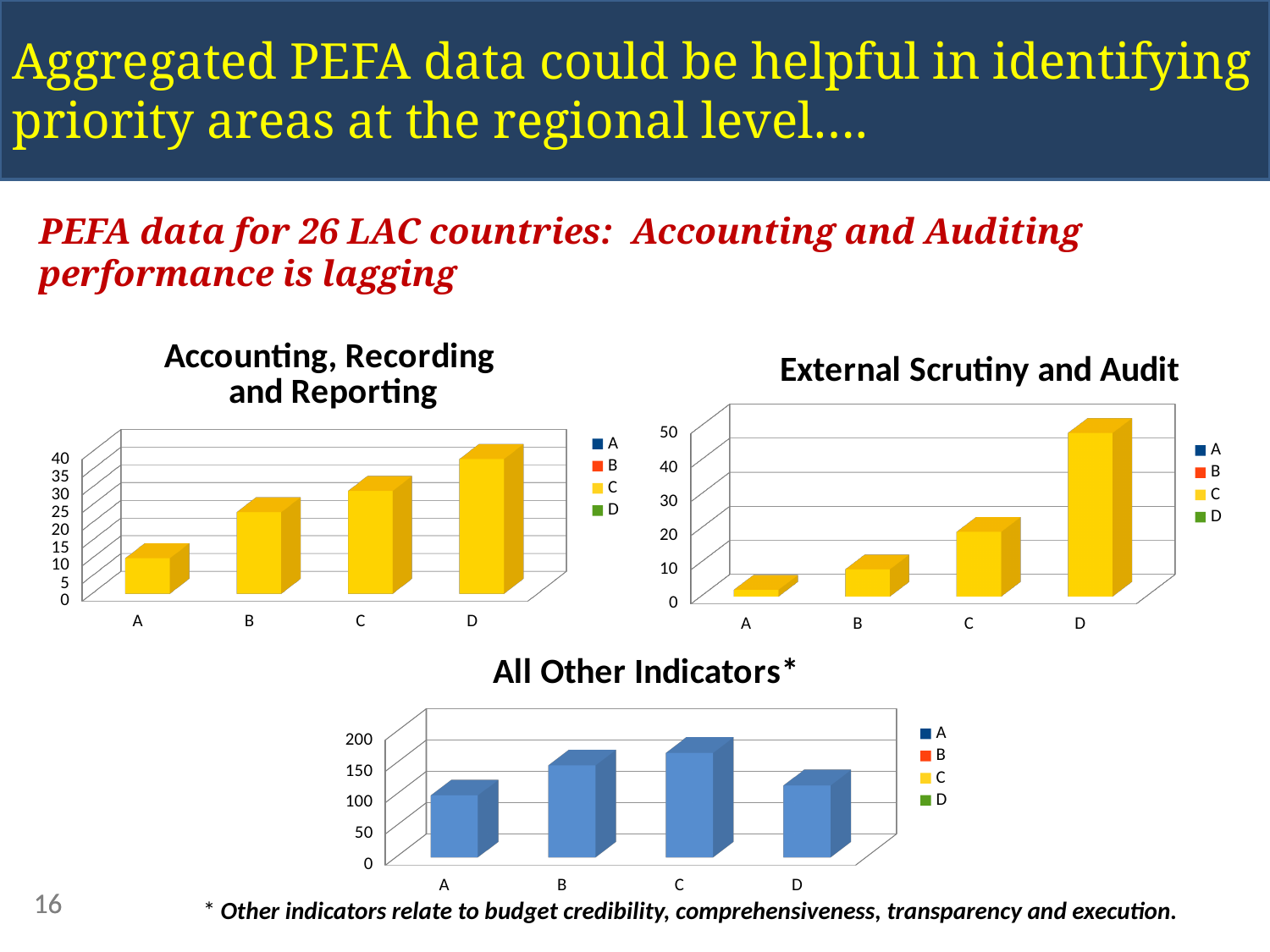
In the 'Accounting, Recording and Reporting' chart, which category has the highest value? D In the 'External Scrutiny and Audit' chart, which category has the highest value? D In the 'Accounting, Recording and Reporting' chart, is the value for D greater or less than 30? greater In the 'External Scrutiny and Audit' chart, is the value for D greater or less than 40? greater In the 'External Scrutiny and Audit' chart, is the value for C greater or less than 30? less What kind of chart is the 'Accounting, Recording and Reporting' chart? bar chart In the 'All Other Indicators*' chart, which is larger, the value for B or the value for D? B How many entries does the legend of the 'All Other Indicators*' chart list? 4 How many categories are shown on the x axis of the 'External Scrutiny and Audit' chart? 4 In the 'Accounting, Recording and Reporting' chart, do the values rise or fall from A to D? rise In the 'Accounting, Recording and Reporting' chart, which category has the lowest value? A